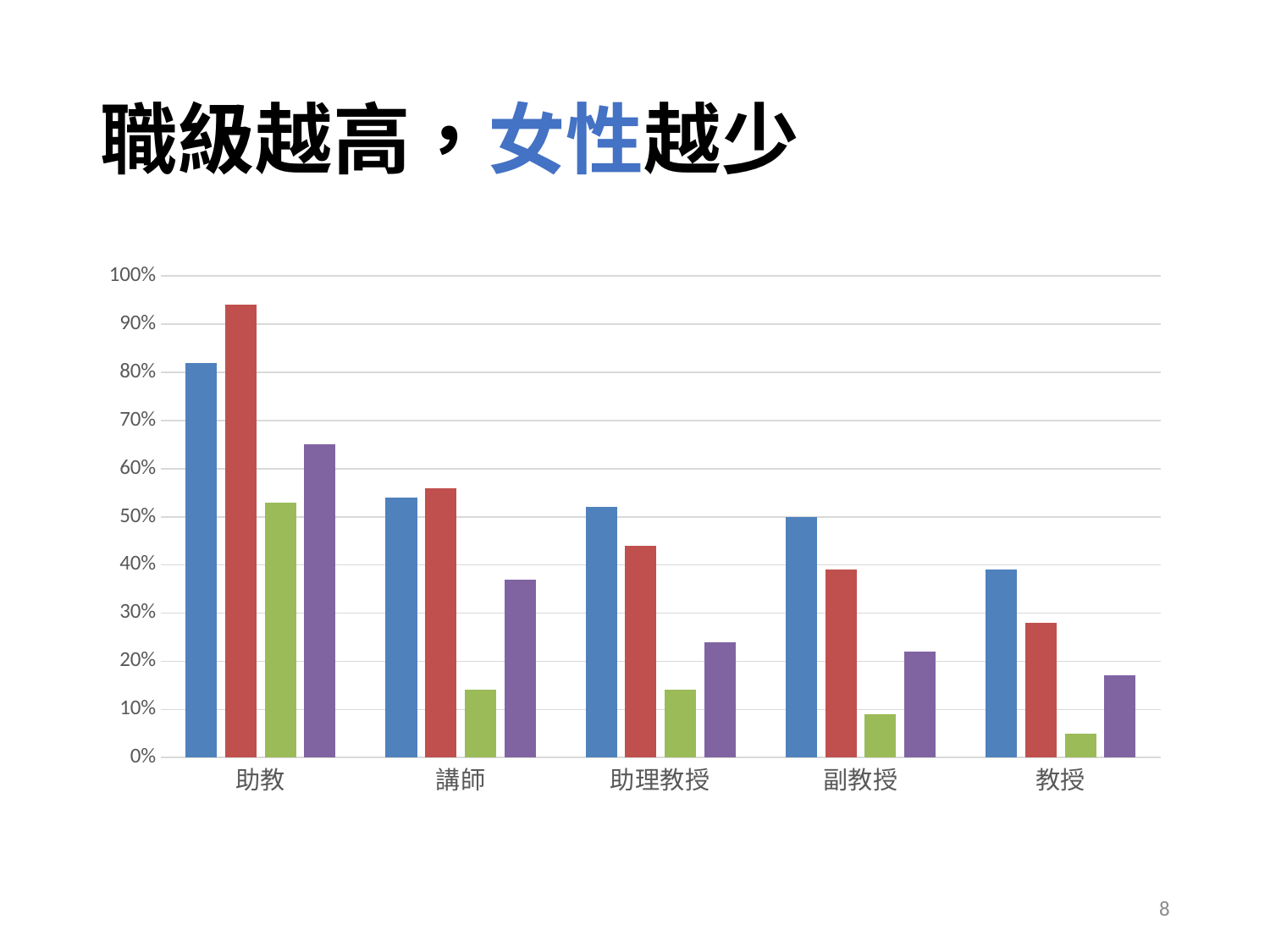
Is the red bar for 助教 greater or less than 90%? greater For 助理教授, which bar is taller, the blue bar or the red bar? blue Which category has the shortest green bar? 教授 What kind of chart is shown on the slide? bar chart Do the blue bars rise or fall moving from 助教 to 教授 along the x axis? fall Is the green bar for 教授 greater or less than 10%? less For 助教, which bar is taller, the blue bar or the red bar? red Which category has the tallest red bar? 助教 How many bars are plotted for each category in the chart? 4 Which category has the tallest purple bar? 助教 Is the purple bar for 講師 greater or less than 30%? greater How many categories are shown on the x axis of the chart? 5